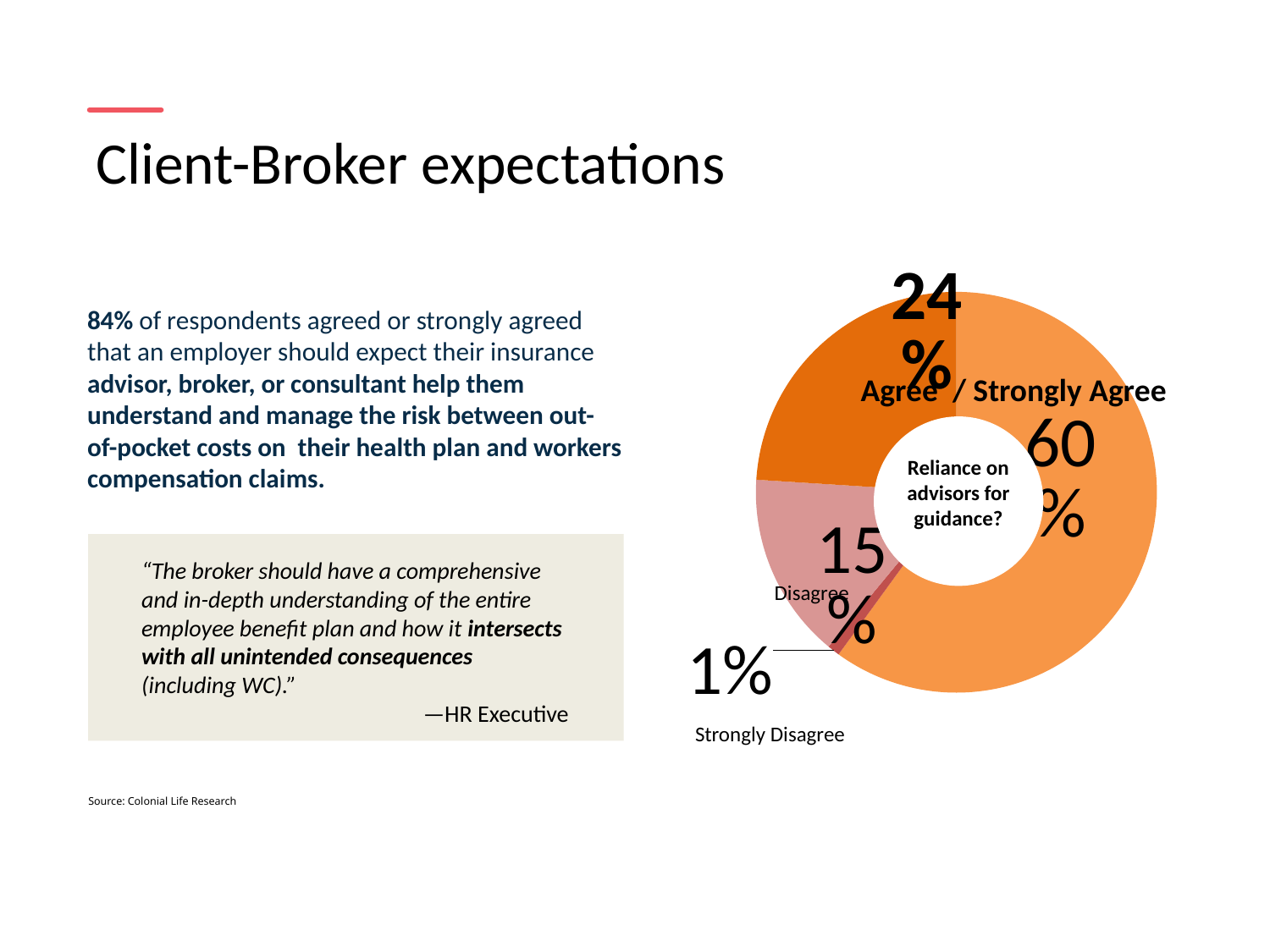
What question is written in the centre of the donut chart? Reliance on advisors for guidance? What kind of chart is shown on the slide? Pie (donut) chart What percentage is shown for Strongly Disagree on the donut chart? 1% What percentage is shown for Disagree on the donut chart? 15% What label is shown for the two orange slices of the donut chart? Agree / Strongly Agree What is the largest value shown on the donut chart? 60% What is the difference between the two largest values shown on the donut chart (60% and 24%)? 36% Which category has the smallest slice on the donut chart? Strongly Disagree Which is larger on the donut chart, Disagree or Strongly Disagree? Disagree What is the combined share of the two slices labelled Agree / Strongly Agree (60% and 24%)? 84% What is the difference between the Disagree and Strongly Disagree values on the donut chart? 14% How many slices does the donut chart have? 4